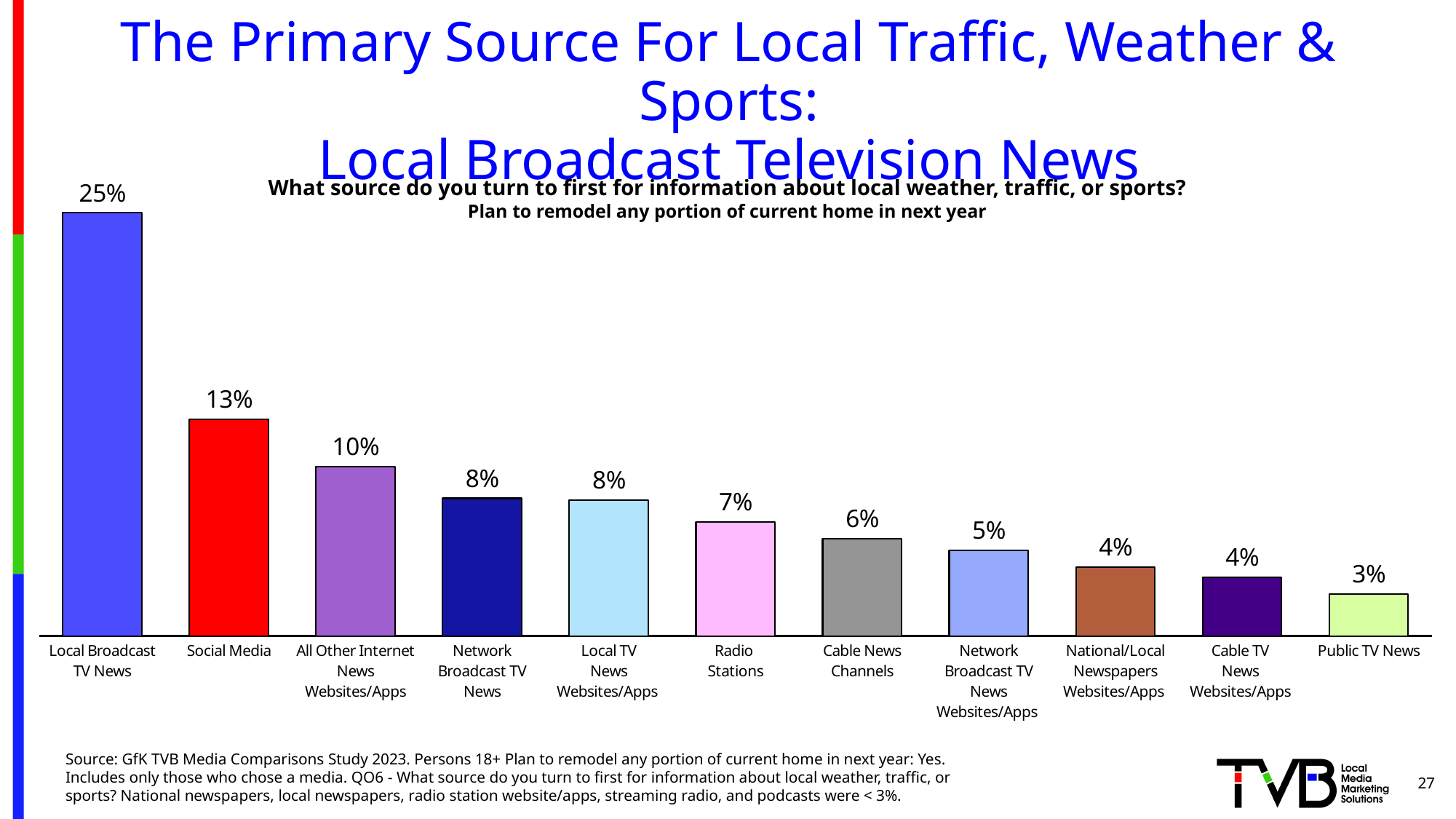
Which is larger, the value for All Other Internet News Websites/Apps or the value for Radio Stations? All Other Internet News Websites/Apps What percentage of respondents turn first to Local Broadcast TV News for local weather, traffic, or sports? 25% Which source has the highest percentage on the chart? Local Broadcast TV News How many sources (bars) are shown on the chart? 11 Do the values rise or fall moving from left to right across the chart? Fall What is the difference in percentage points between Local Broadcast TV News and Social Media? 12 What is the value shown for Cable News Channels? 6% What type of chart is shown on the slide? Bar chart What is the value shown for Social Media? 13% What colour is the bar for Social Media? Red Which source has the lowest percentage on the chart? Public TV News What is the value shown for Radio Stations? 7%